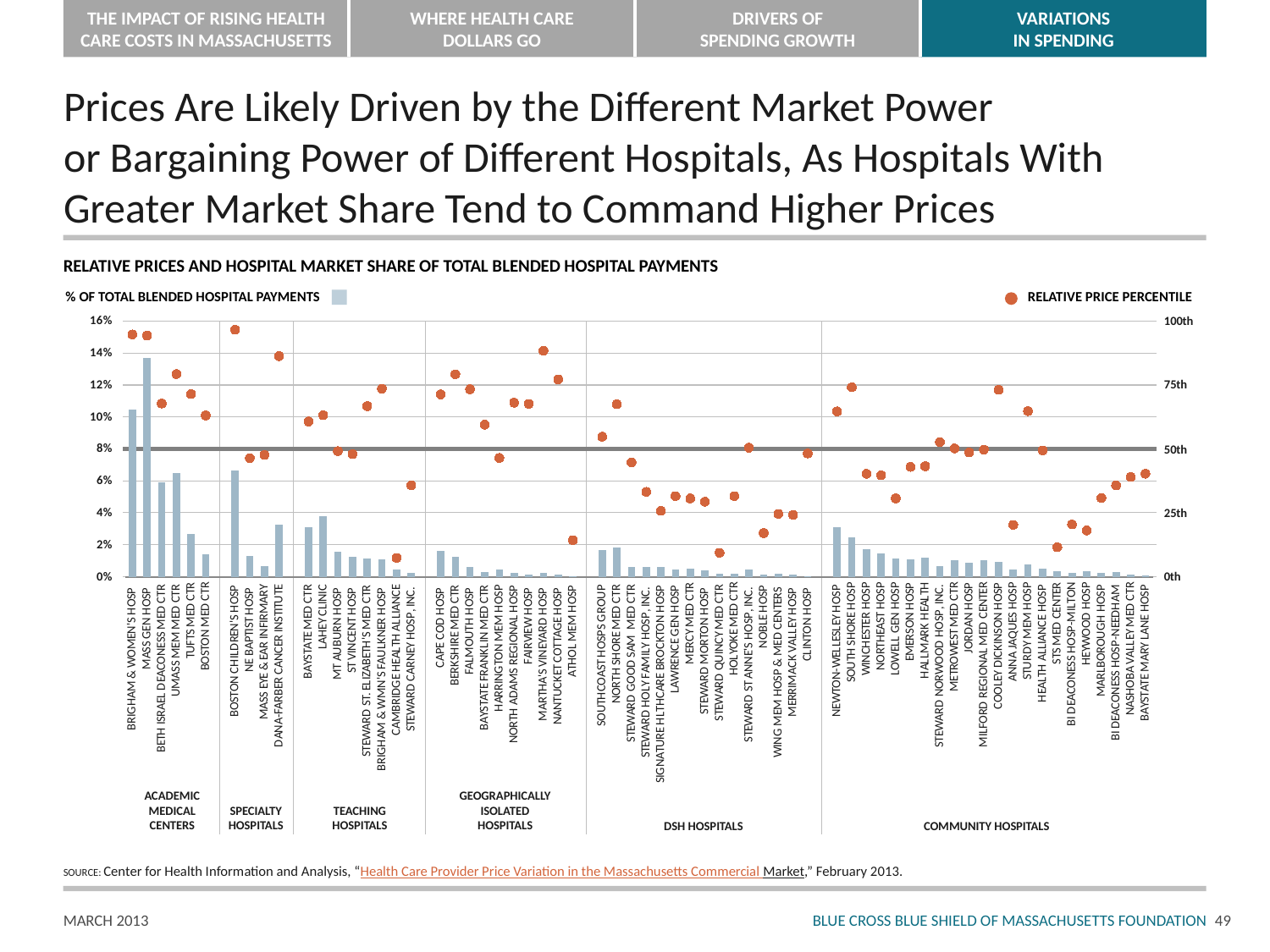
Is the % of total blended hospital payments for Boston Children's Hosp greater or less than 8%? less Which hospital has the highest % of total blended hospital payments? Mass Gen Hosp What is the title of the chart? Relative Prices and Hospital Market Share of Total Blended Hospital Payments What kind of chart is this? A combined bar and dot (scatter) chart Is the relative price percentile for Brigham & Women's Hosp greater or less than the 75th percentile? greater Is the relative price percentile for Steward Morton Hosp greater or less than the 25th percentile? greater Which has a larger % of total blended hospital payments, Mass Gen Hosp or Brigham & Women's Hosp? Mass Gen Hosp Which has a higher relative price percentile, Boston Children's Hosp or NE Baptist Hosp? Boston Children's Hosp How many series does the chart legend list? 2 How many hospital groups are shown along the x axis? 6